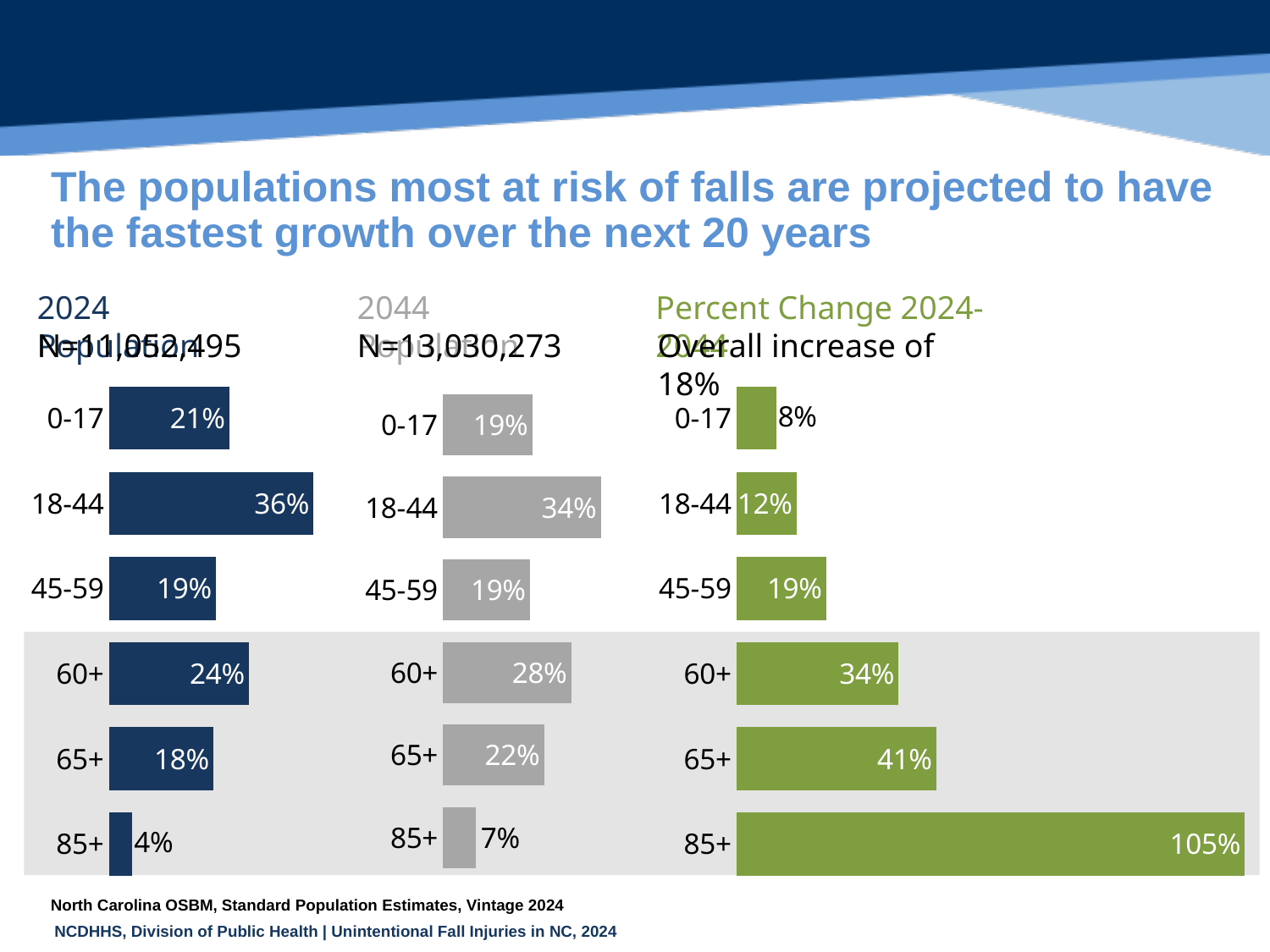
In the 2044 chart in the middle, which age group has the highest value? 18-44 In the 2024 chart on the left, which age group has the lowest value? 85+ In the 2024 chart on the left, what is the value for the 18-44 age group? 36% In the 2044 chart in the middle, what is the difference between the 60+ value and the 85+ value? 21% In the Percent Change 2024-2044 chart on the right, what is the difference between the 85+ value and the 0-17 value? 97% What colour are the bars in the Percent Change 2024-2044 chart on the right? Green In the 2044 chart in the middle, what is the value for the 65+ age group? 22% What kind of chart is the Percent Change 2024-2044 chart on the right? Bar chart In the 2024 chart on the left, how many age groups are shown? 6 In the Percent Change 2024-2044 chart on the right, which is larger: the value for 60+ or the value for 65+? 65+ In the Percent Change 2024-2044 chart on the right, which age group has the highest value? 85+ In the Percent Change 2024-2044 chart on the right, what is the value for the 85+ age group? 105%